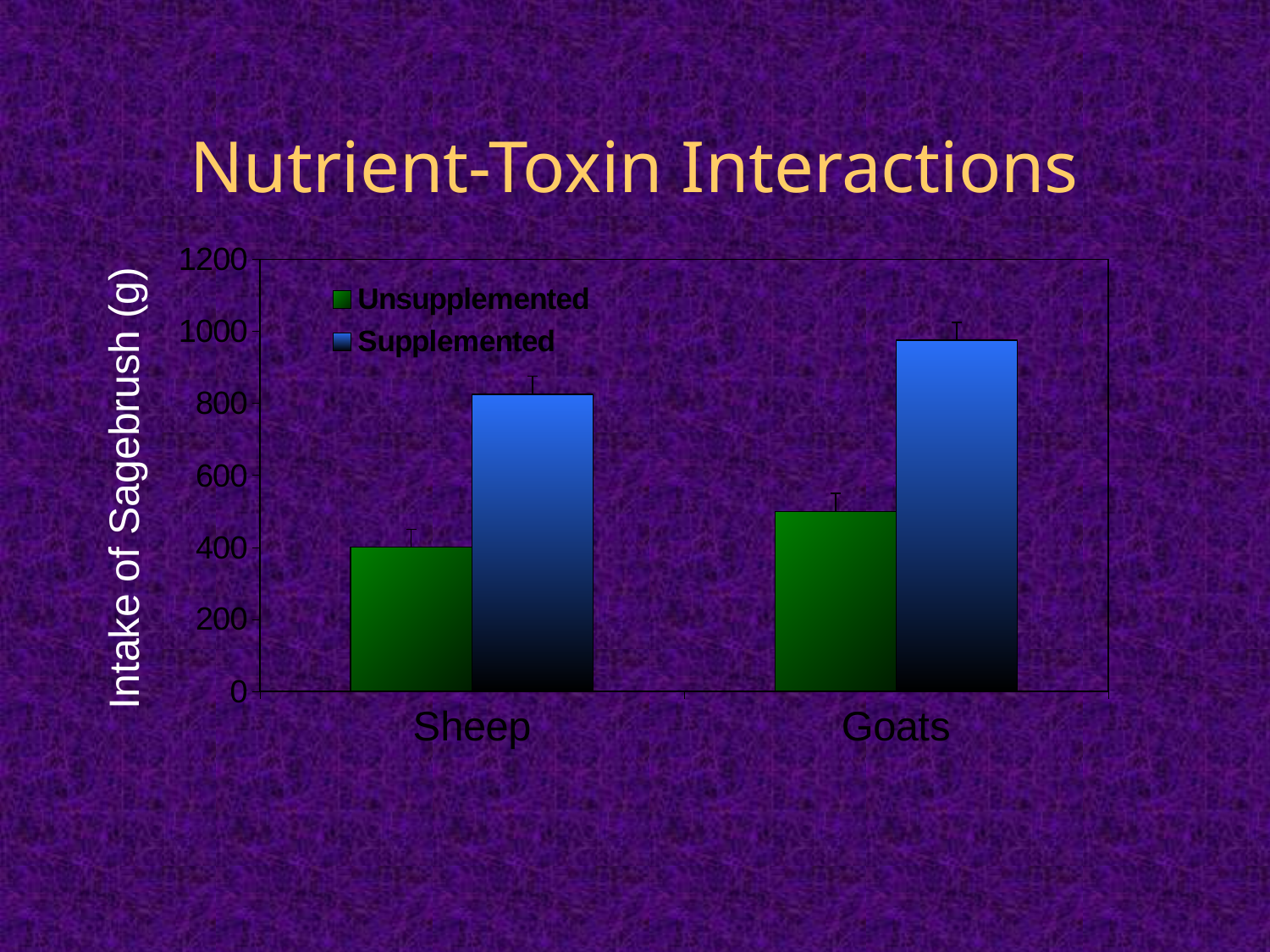
What colour are the Unsupplemented bars? green Is the Supplemented value for Sheep greater or less than 600? greater Which category has the higher Supplemented value, Sheep or Goats? Goats What is the label of the y axis? Intake of Sagebrush (g) Which category has the higher Unsupplemented value, Sheep or Goats? Goats Which series has the higher value for Sheep, Unsupplemented or Supplemented? Supplemented What kind of chart is shown on the slide? bar chart Is the Unsupplemented value for Goats greater or less than 600? less How many series does the legend list? 2 How many categories are shown on the x axis? 2